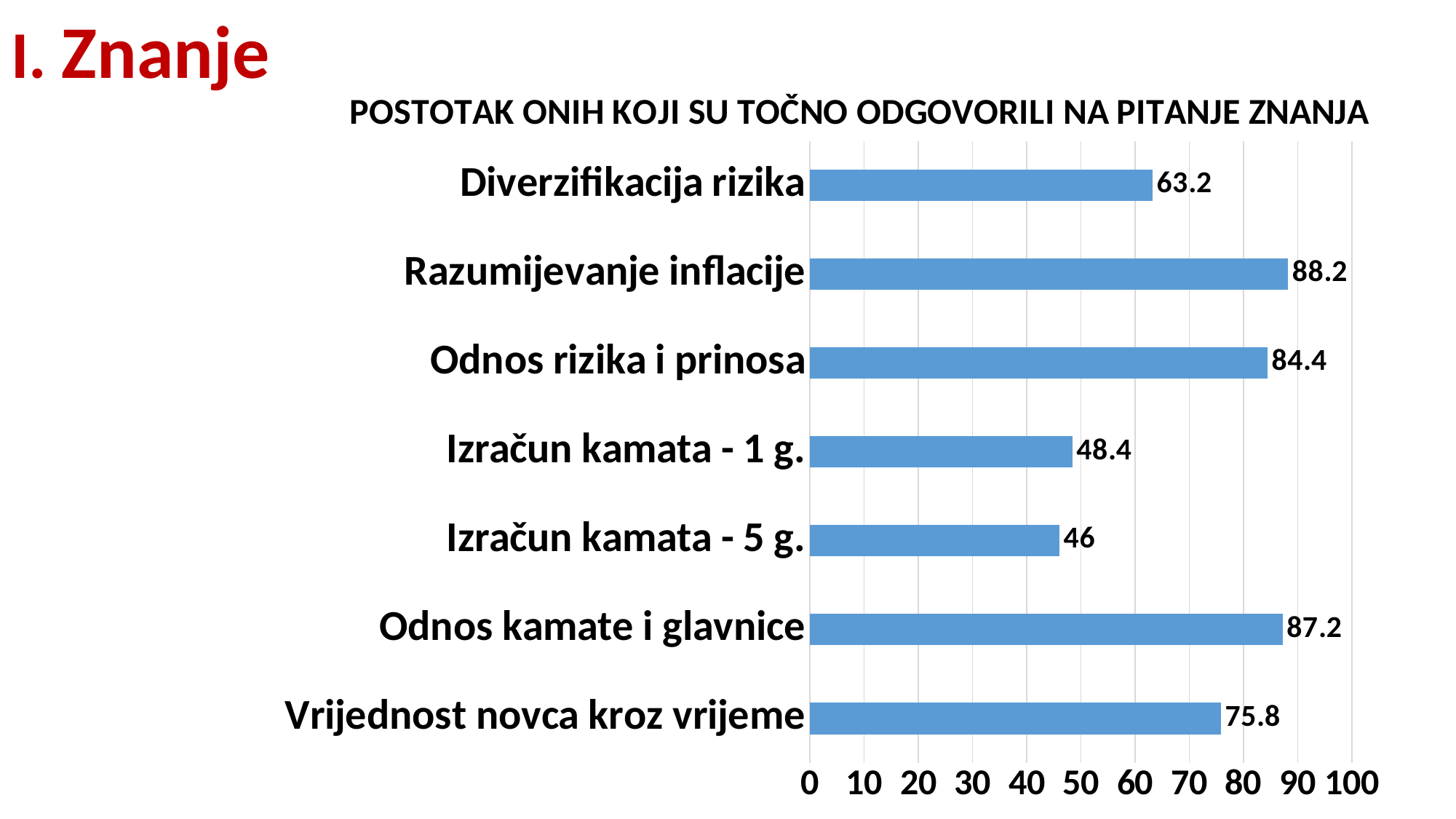
What is the value for Razumijevanje inflacije? 88.2 What is the difference between the values for Odnos rizika i prinosa and Diverzifikacija rizika? 21.2 What is the maximum value shown on the horizontal axis? 100 What is the title of the chart? POSTOTAK ONIH KOJI SU TOČNO ODGOVORILI NA PITANJE ZNANJA Is the value for Izračun kamata - 1 g. greater or less than 50? less What is the value for Vrijednost novca kroz vrijeme? 75.8 What is the value for Izračun kamata - 5 g.? 46 What kind of chart is shown on the slide? bar chart Which category has the highest value? Razumijevanje inflacije Which is larger, the value for Odnos kamate i glavnice or the value for Vrijednost novca kroz vrijeme? Odnos kamate i glavnice Which category has the lowest value? Izračun kamata - 5 g. How many categories are shown in the chart? 7